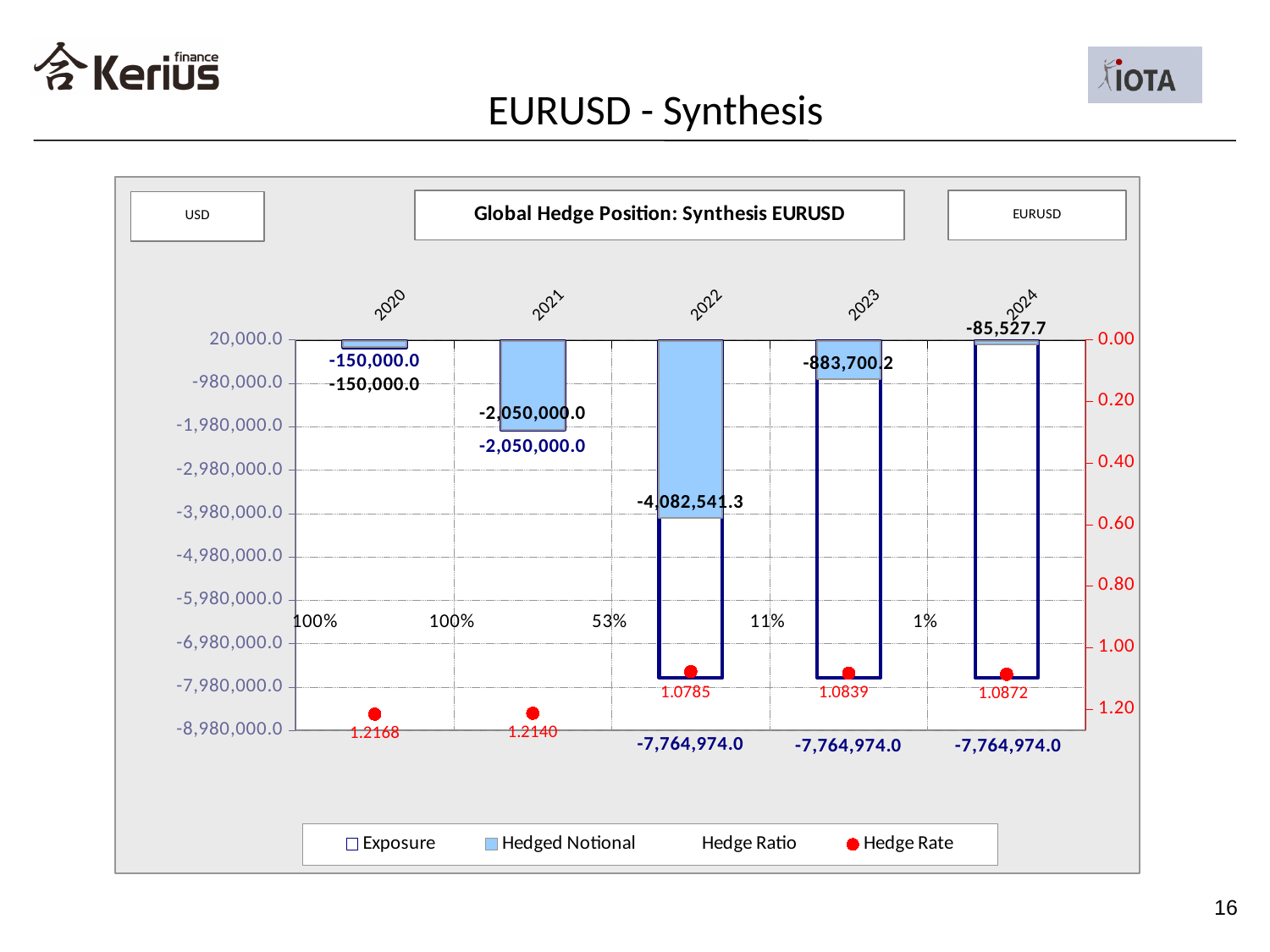
What is the title of the chart? Global Hedge Position: Synthesis EURUSD What is the difference between the Exposure and the Hedged Notional in 2023? 6,881,273.8 What is the Hedged Notional value for 2022? -4,082,541.3 How many series does the legend list? 4 What is the Hedge Ratio shown for 2023? 11% How many years are shown on the x axis of the chart? 5 Does the Hedge Ratio rise or fall from 2020 to 2024? fall What is the Exposure value for 2024? -7,764,974.0 Which year has the lowest Hedge Rate? 2022 Which year has the lowest Hedge Ratio? 2024 Which year has the highest Hedge Rate? 2020 What is the Hedge Rate for 2020? 1.2168